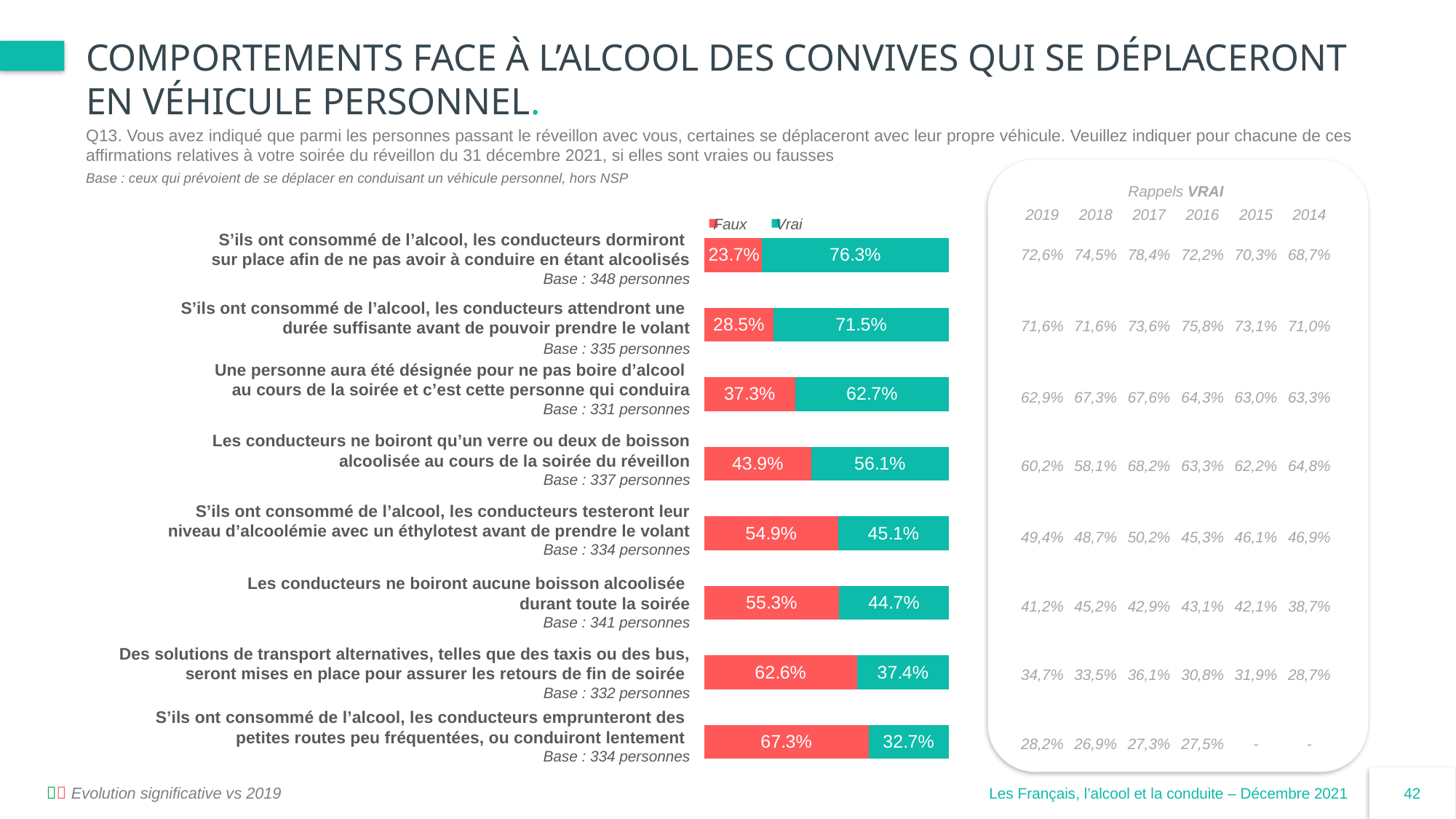
Which statement has the lowest 'Vrai' value? S'ils ont consommé de l'alcool, les conducteurs emprunteront des petites routes peu fréquentées, ou conduiront lentement Which statement has the highest 'Vrai' value? S'ils ont consommé de l'alcool, les conducteurs dormiront sur place afin de ne pas avoir à conduire en étant alcoolisés What is the 'Vrai' value for the statement that a designated person will not drink alcohol and will drive? 62.7% What is the 'Vrai' value for the statement that drivers who have consumed alcohol will sleep on site (dormiront sur place)? 76.3% How many statements are plotted in the bar chart? 8 What kind of chart is used to show the Faux/Vrai results? Stacked bar chart What is the 'Faux' value for the statement that drivers will test their blood alcohol level with a breathalyser before driving? 54.9% How many series does the chart legend list? 2 What is the 'Faux' value for the statement that alternative transport solutions such as taxis or buses will be put in place? 62.6% What is the difference between the 'Vrai' and 'Faux' values for the statement that drivers will wait a sufficient time before driving? 43 percentage points What is the total of the 'Faux' and 'Vrai' values for the statement that drivers will not drink any alcoholic drink during the whole evening? 100% For the statement that drivers will drink only one or two alcoholic drinks, which is larger: the 'Faux' value or the 'Vrai' value? Vrai